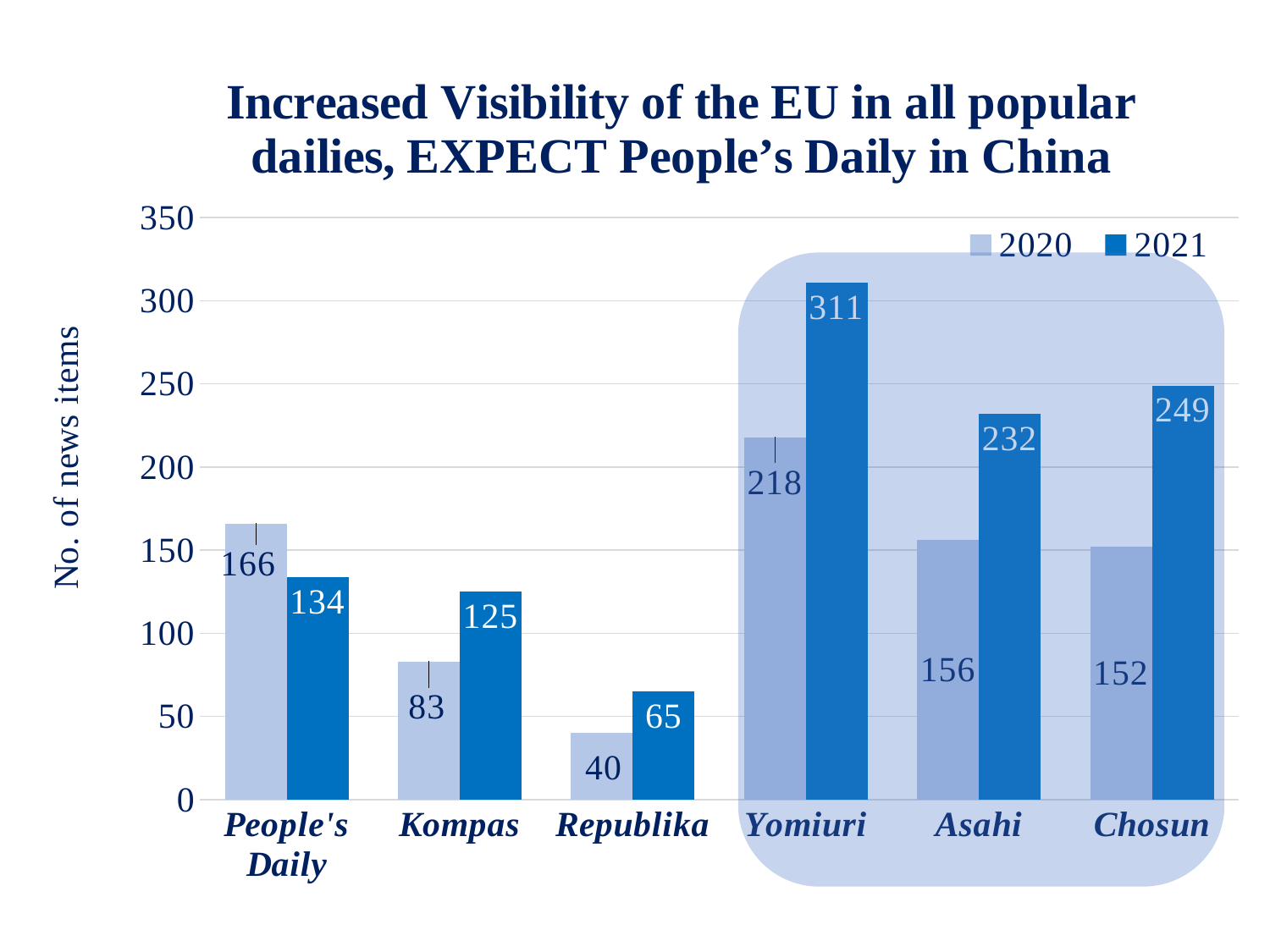
What is the 2020 value for People's Daily? 166 How many series does the legend list? 2 Which daily has the highest 2021 value? Yomiuri What is the difference between the 2021 and 2020 values for Chosun? 97 What is the 2020 value for Kompas? 83 What is the 2021 value for Yomiuri? 311 How many dailies are shown on the x axis? 6 For People's Daily, which is larger: the 2020 value or the 2021 value? 2020 Is the 2021 value for Asahi greater or less than 200? greater What kind of chart is shown? bar chart Which daily has the lowest 2020 value? Republika What is the label of the y axis? No. of news items